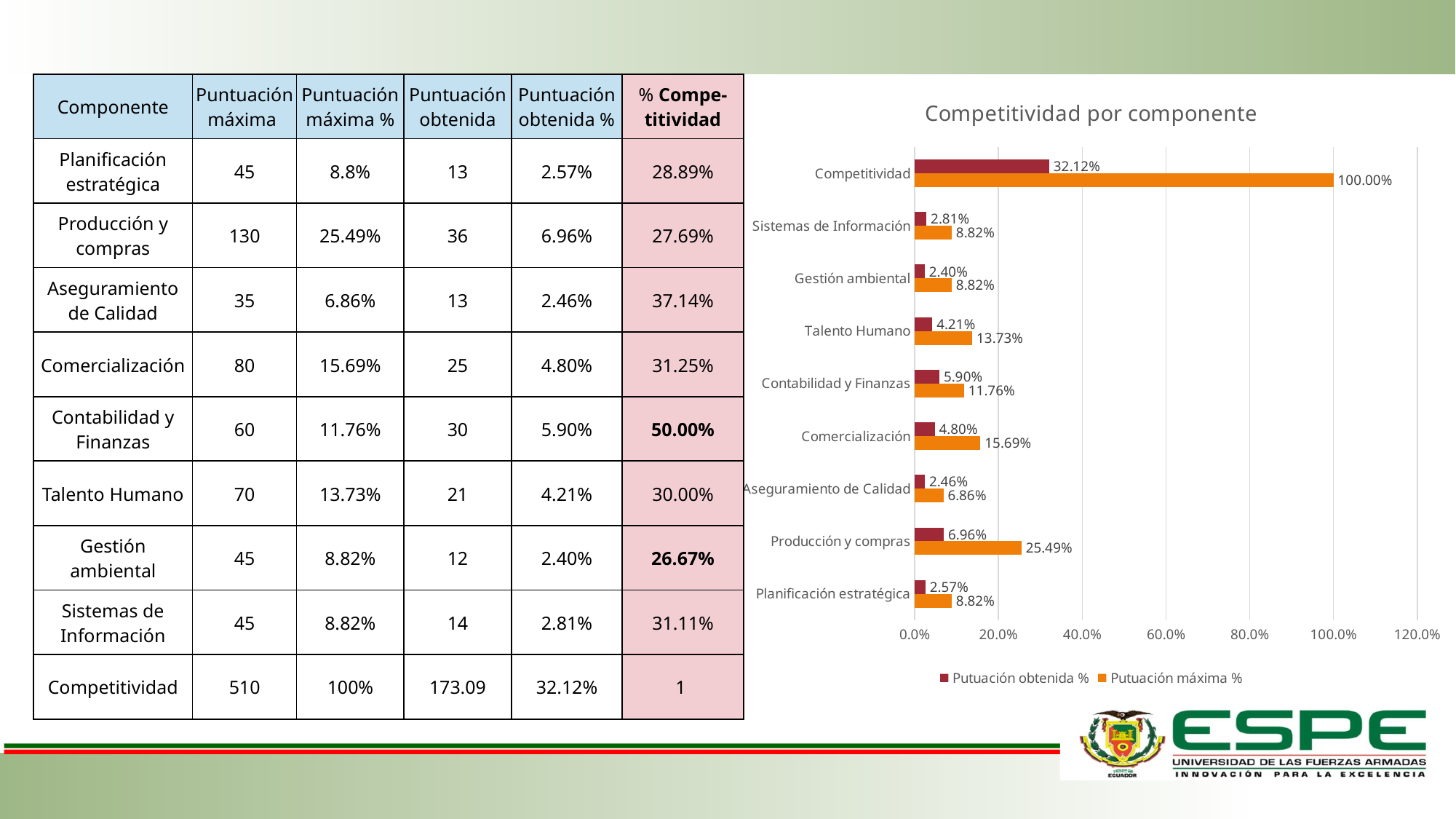
What is the Putuación máxima % value for Talento Humano in the chart? 13.73% Excluding the Competitividad total, which category has the highest Putuación máxima % in the chart? Producción y compras Is the Putuación máxima % bar for Producción y compras greater or less than 20.0% in the chart? greater What is the Putuación obtenida % value for Contabilidad y Finanzas in the chart? 5.90% What is the difference between the Putuación máxima % and the Putuación obtenida % for Comercialización in the chart? 10.89% What is the title of the chart? Competitividad por componente Which is larger in the chart: the Putuación obtenida % for Talento Humano or for Sistemas de Información? Talento Humano Excluding the Competitividad total, which category has the lowest Putuación obtenida % in the chart? Gestión ambiental What is the Putuación obtenida % value for Producción y compras in the chart? 6.96% What type of chart is shown on the slide? bar chart How many series does the chart legend list? 2 How many categories are shown on the chart's vertical axis? 9